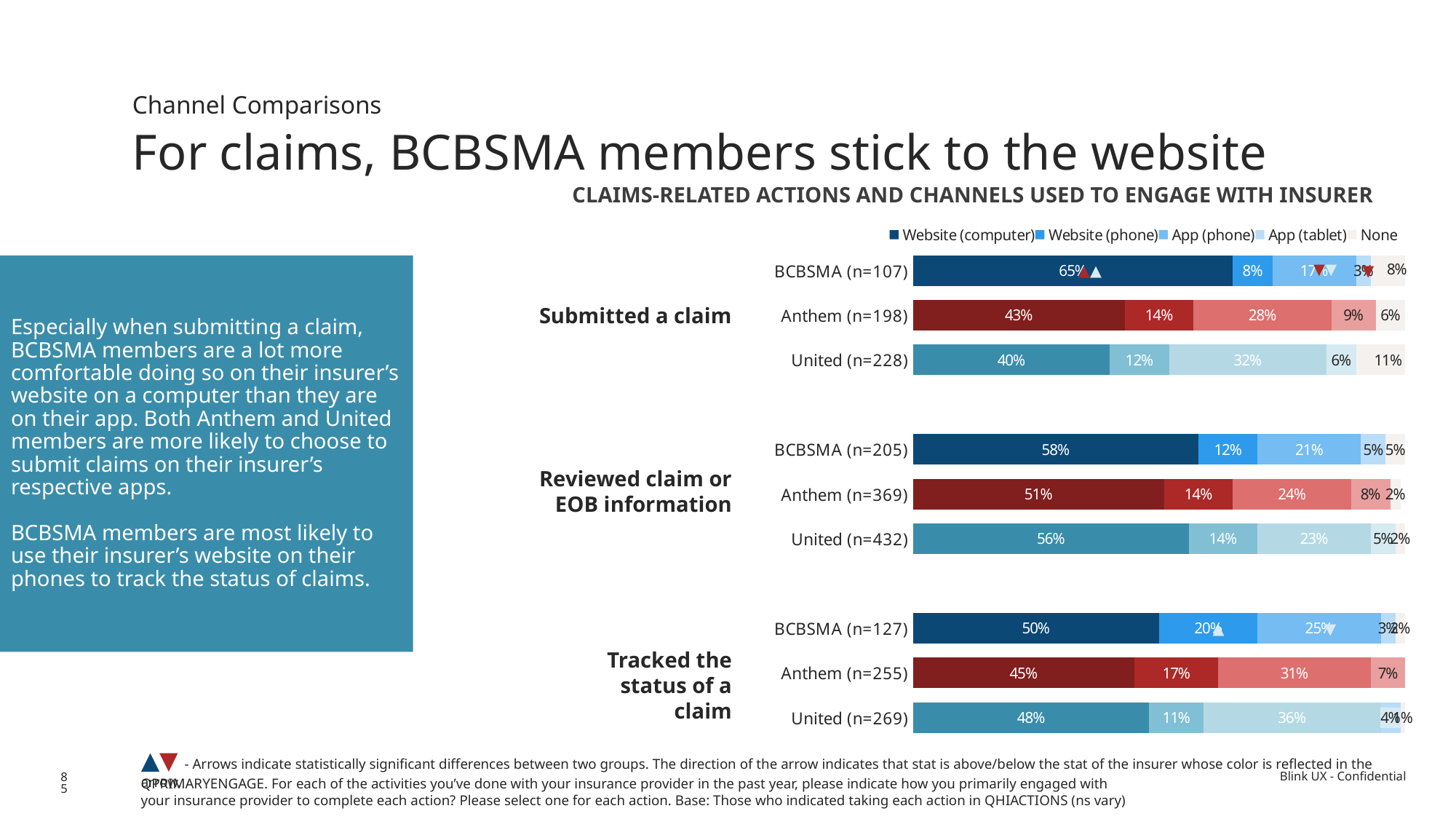
What percentage of Anthem members (n=198) who submitted a claim used the app on a phone? 28% For reviewing claim or EOB information, what percentage of Anthem members (n=369) used the website on a computer? 51% What kind of chart is shown on the slide? Stacked bar chart What percentage of BCBSMA members (n=107) who submitted a claim used the website on a computer? 65% For submitting a claim, what is the difference between the Website (computer) percentages of BCBSMA (n=107) and Anthem (n=198)? 22 percentage points For submitting a claim, which insurer has the lowest Website (computer) percentage? United (n=228) What is the title of the chart? CLAIMS-RELATED ACTIONS AND CHANNELS USED TO ENGAGE WITH INSURER For reviewing claim or EOB information, which is larger: the Website (computer) share for BCBSMA (n=205) or for United (n=432)? BCBSMA (n=205) For tracking the status of a claim, what percentage of United members (n=269) used the app on a phone? 36% For tracking the status of a claim, which insurer has the highest Website (phone) percentage? BCBSMA (n=127) How many series does the chart legend list? 5 What percentage of United members (n=228) who submitted a claim used none of the channels? 11%